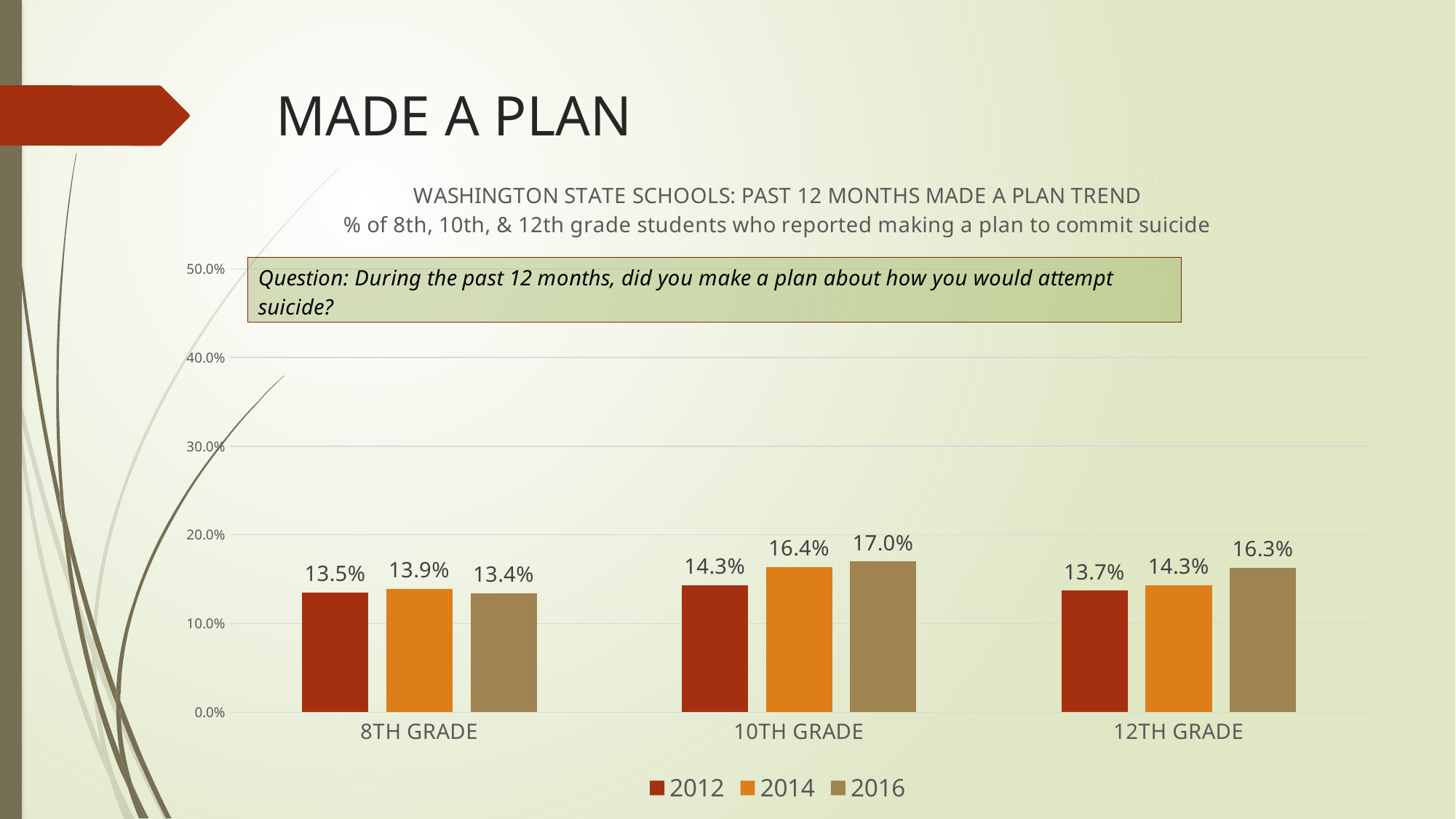
Which years are listed in the legend? 2012, 2014, 2016 Which grade has the highest value for 2016? 10th grade What is the difference between the 2016 and 2012 values for 10th grade? 2.7% Which is larger for 12th grade: the 2014 value or the 2016 value? 2016 What kind of chart is shown on the slide? bar chart What is the value for 2012 for 8th grade? 13.5% Is the value for 2016 for 8th grade greater or less than 20.0%? less How many grade categories are shown on the x axis? 3 What is the value for 2016 for 10th grade? 17.0% How many series does the legend list? 3 What is the value for 2014 for 12th grade? 14.3% Which grade has the lowest value for 2014? 8th grade